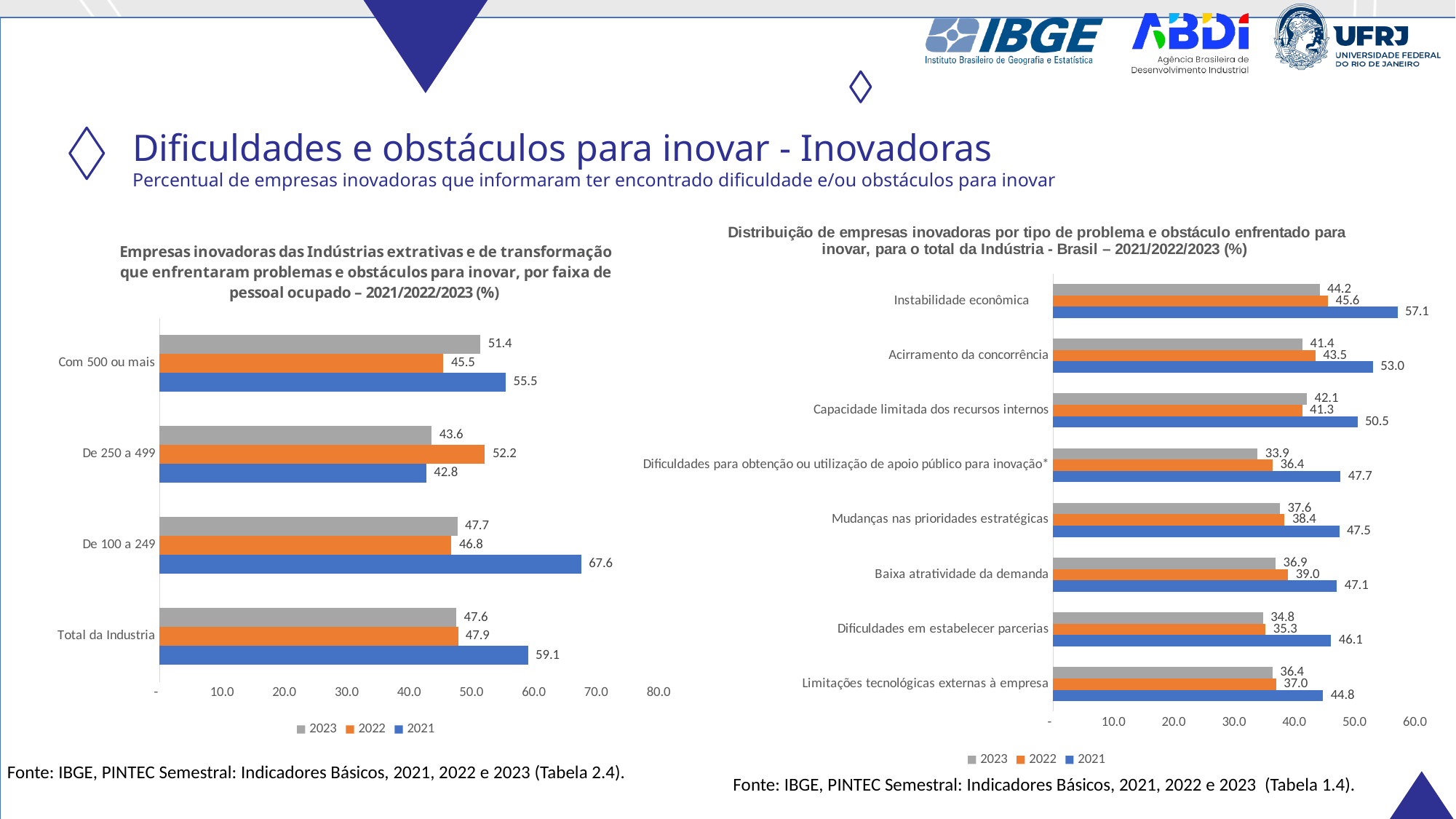
In the right chart (Distribuição de empresas inovadoras por tipo de problema), how many problem categories are shown? 8 In the left chart (Empresas inovadoras ... por faixa de pessoal ocupado), what is the difference between the 2021 and 2023 values for Total da Industria? 11.5 In the right chart (Distribuição de empresas inovadoras por tipo de problema), which category has the lowest 2021 value? Limitações tecnológicas externas à empresa In the left chart (Empresas inovadoras ... por faixa de pessoal ocupado), what is the 2022 value for Com 500 ou mais? 45.5 In the left chart (Empresas inovadoras ... por faixa de pessoal ocupado), what is the 2021 value for De 100 a 249? 67.6 In the left chart (Empresas inovadoras ... por faixa de pessoal ocupado), which category has the highest 2021 value? De 100 a 249 What type of chart is the right chart (Distribuição de empresas inovadoras por tipo de problema)? Bar chart In the right chart (Distribuição de empresas inovadoras por tipo de problema), which is larger for Capacidade limitada dos recursos internos: the 2023 value or the 2022 value? 2023 In the right chart (Distribuição de empresas inovadoras por tipo de problema), what is the 2023 value for Dificuldades em estabelecer parcerias? 34.8 In the right chart (Distribuição de empresas inovadoras por tipo de problema), what is the 2021 value for Instabilidade econômica? 57.1 In the right chart (Distribuição de empresas inovadoras por tipo de problema), what is the difference between the 2021 and 2022 values for Acirramento da concorrência? 9.5 In the left chart (Empresas inovadoras ... por faixa de pessoal ocupado), how many series does the legend list? 3